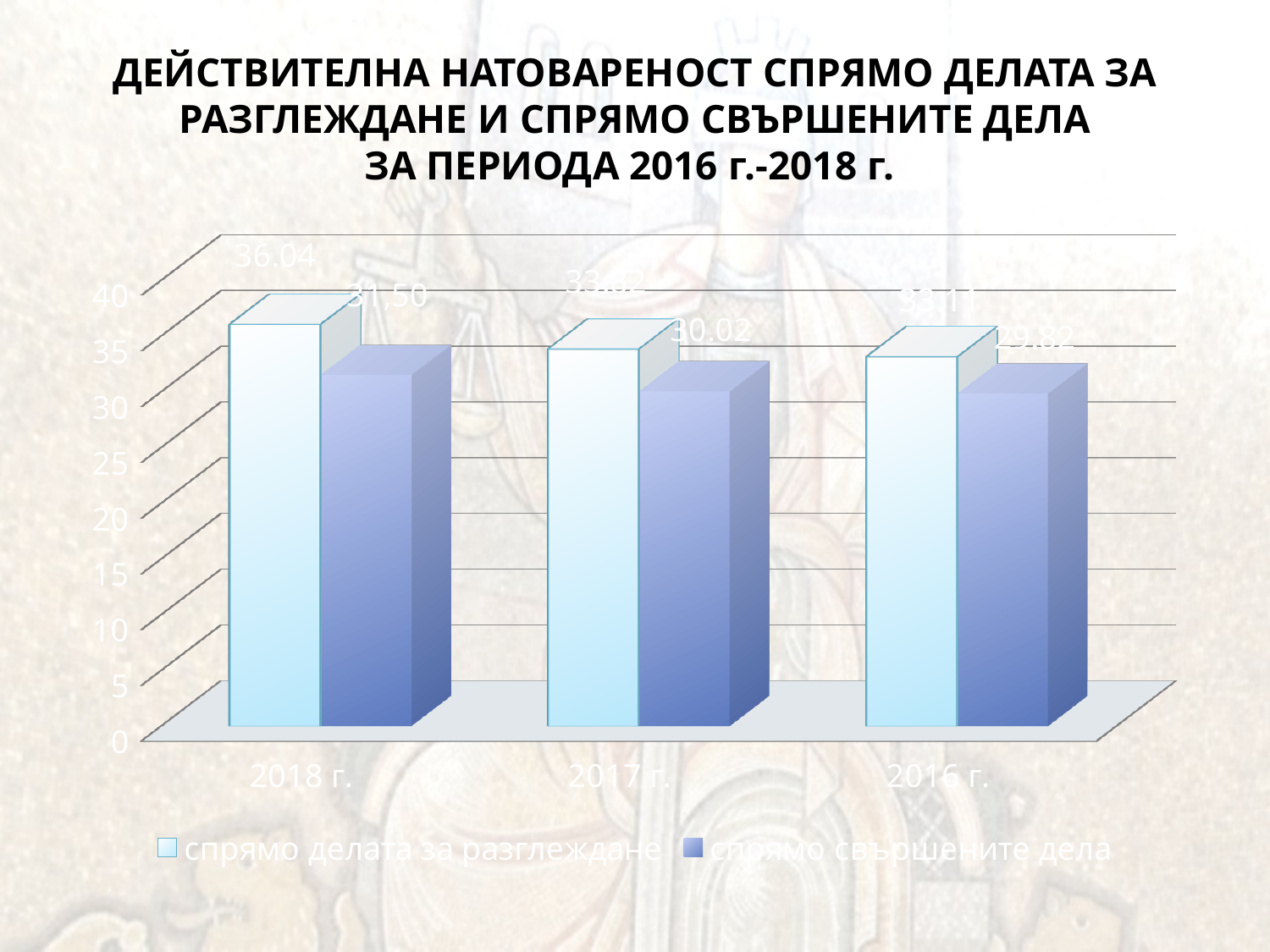
What is the value for 'спрямо свършените дела' in 2017 г.? 30.02 What is the value for 'спрямо свършените дела' in 2016 г.? 29.82 How many year categories are shown on the x axis? 3 Do the values for 'спрямо делата за разглеждане' rise or fall moving left to right along the x axis? fall Is the value for 'спрямо делата за разглеждане' in 2018 г. greater or less than 35? greater What is the value for 'спрямо свършените дела' in 2018 г.? 31.50 What is the value for 'спрямо делата за разглеждане' in 2018 г.? 36.04 Which year has the lowest value for 'спрямо свършените дела'? 2016 г. How many series does the legend list? 2 What kind of chart is shown on the slide? bar chart What is the difference between the two series values for 2018 г.? 4.54 Which year has the highest value for 'спрямо свършените дела'? 2018 г.